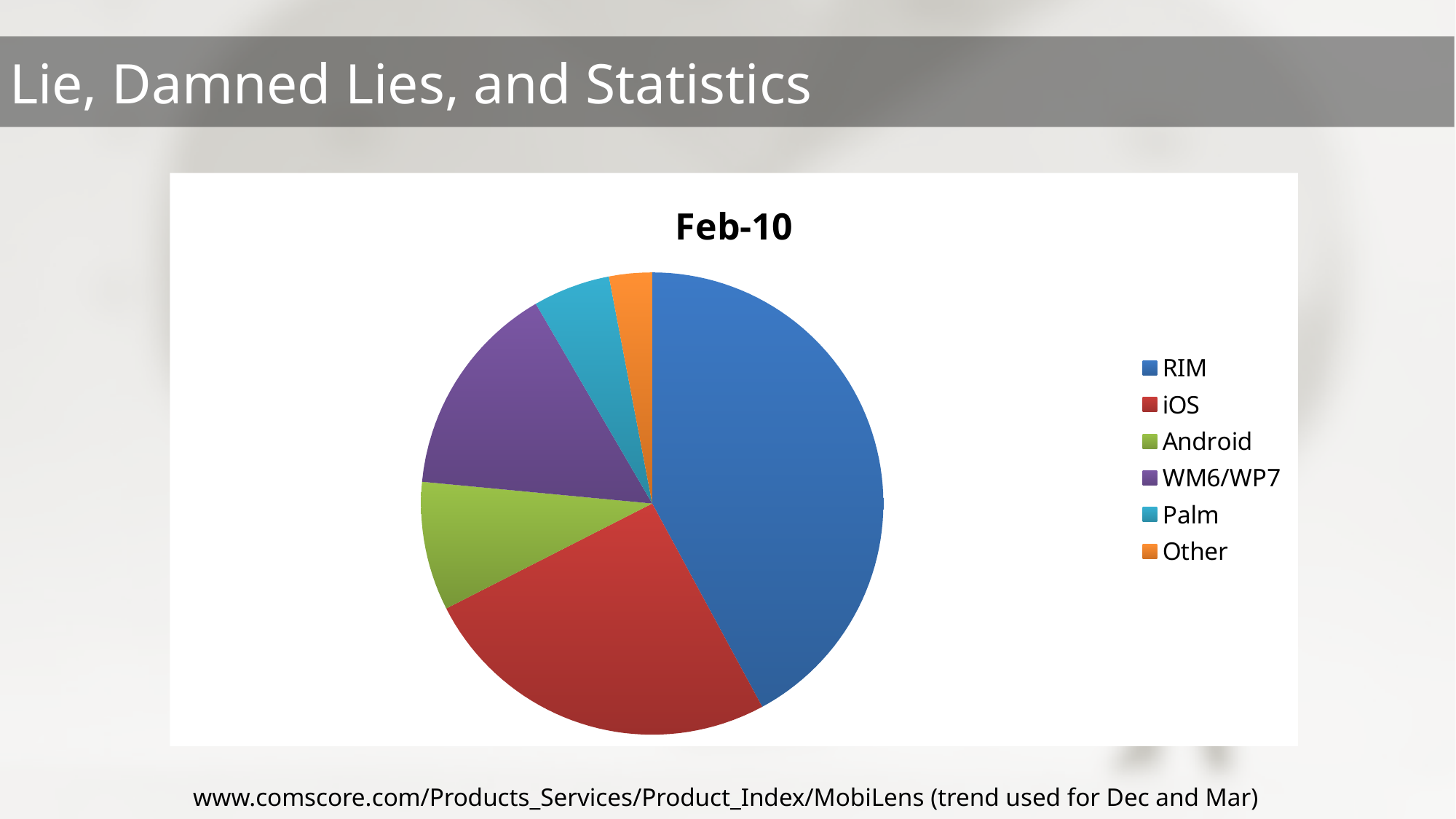
Which slice is larger, Palm or Other? Palm What kind of chart is shown on the slide? pie chart Which slice is larger, iOS or Android? iOS Which category has the smallest slice of the pie? Other Which slice is larger, WM6/WP7 or Android? WM6/WP7 What colour is the RIM slice in the pie chart? blue What is the title of the chart? Feb-10 How many entries does the legend list? 6 Which category has the largest slice of the pie? RIM How many slices does the pie chart have? 6